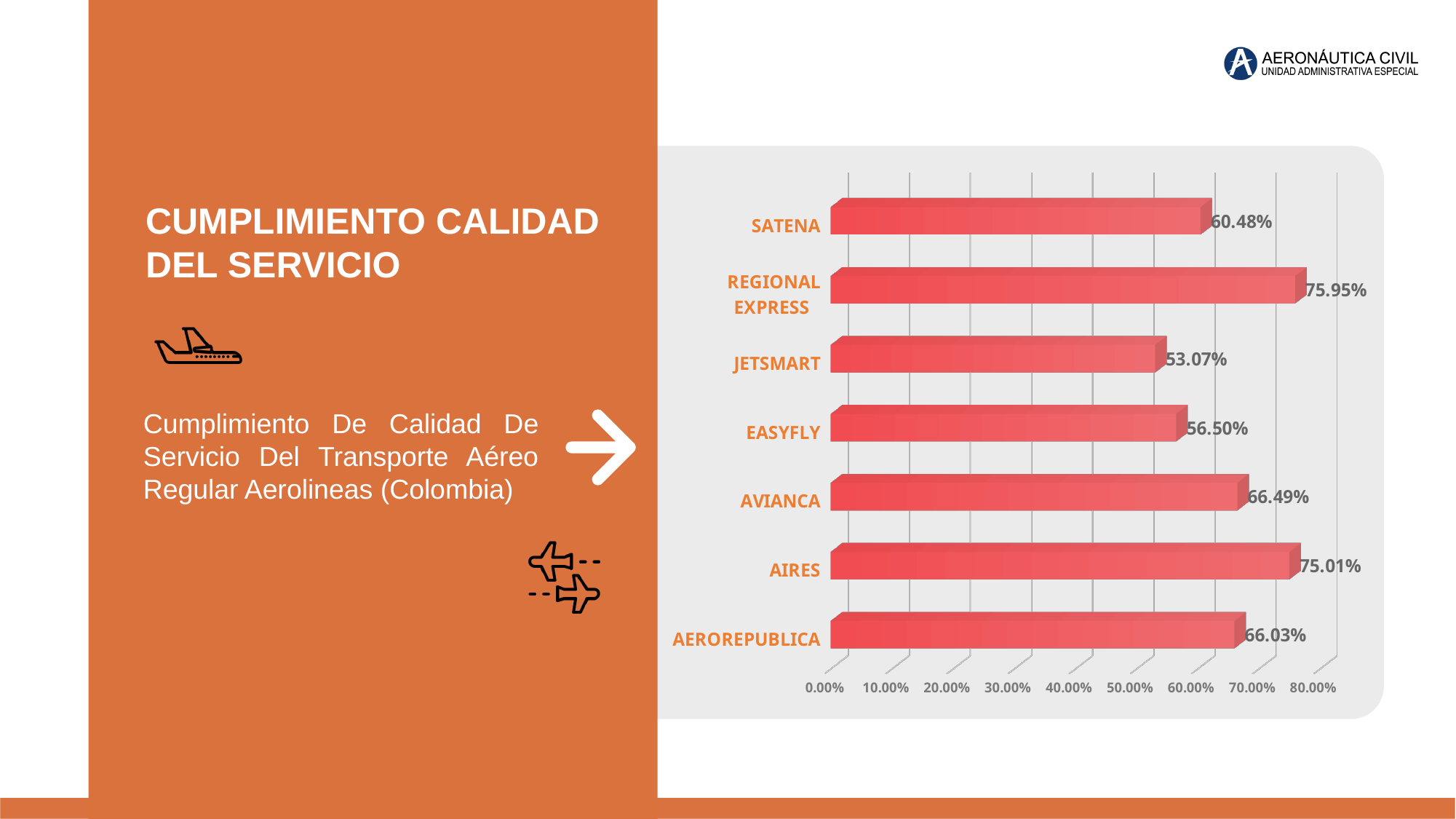
What is the value for REGIONAL EXPRESS? 75.95% Which airline has the highest value? REGIONAL EXPRESS What is the difference between the values for AVIANCA and EASYFLY? 9.99% How many airlines are shown in the chart? 7 What is the highest tick value shown on the horizontal axis? 80.00% What is the value for JETSMART? 53.07% What is the value for SATENA? 60.48% Which is larger, the value for AIRES or the value for SATENA? AIRES What kind of chart is shown on the slide? bar chart Which airline has the lowest value? JETSMART What is the value for AEROREPUBLICA? 66.03% Is the value for EASYFLY greater or less than 60.00%? less